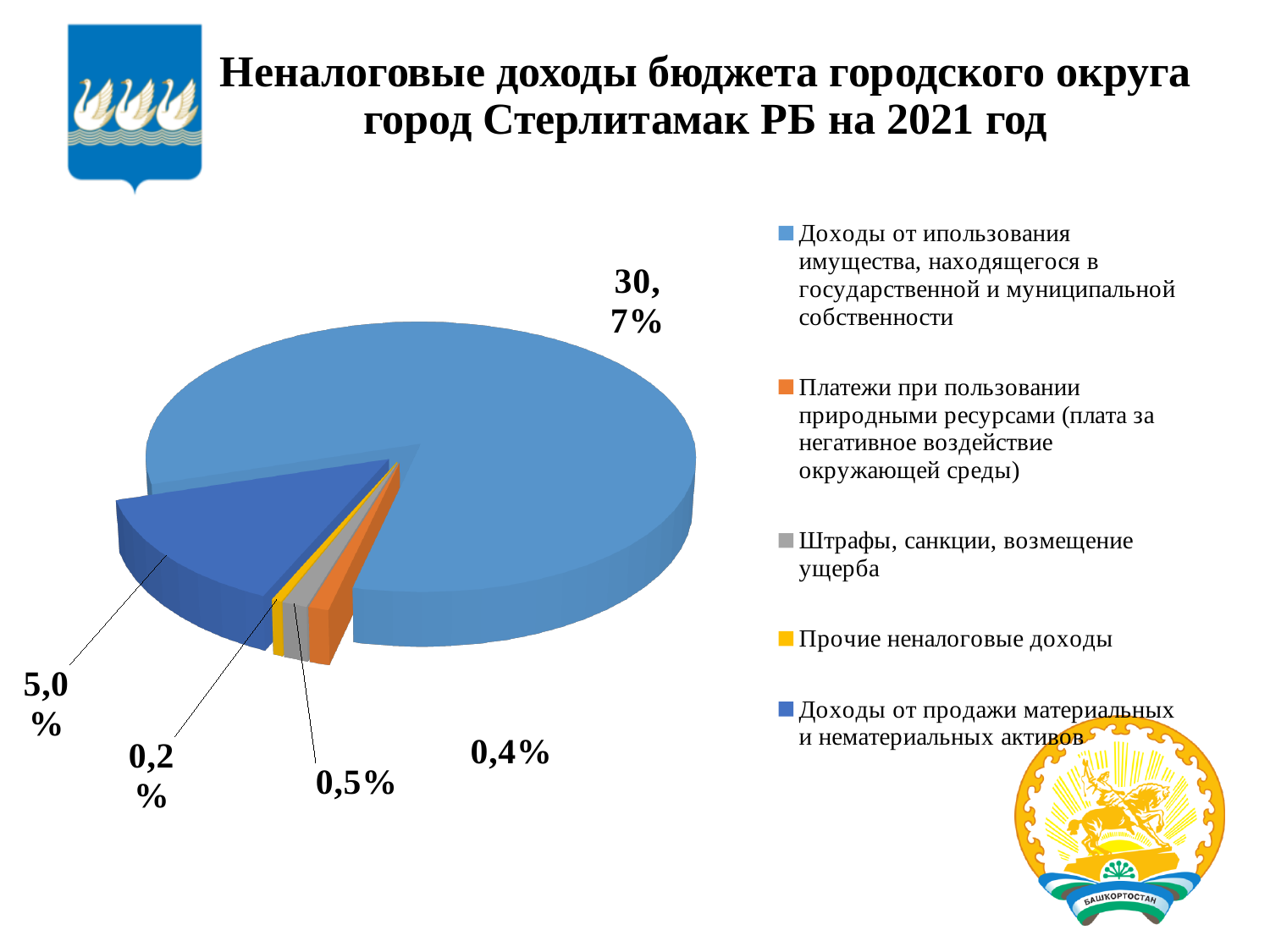
Which category has the largest slice in the pie chart? Доходы от ипользования имущества, находящегося в государственной и муниципальной собственности What is the title of the slide containing the chart? Неналоговые доходы бюджета городского округа город Стерлитамак РБ на 2021 год What is the value shown for "Прочие неналоговые доходы"? 0,2% Which category has the smallest value in the pie chart? Прочие неналоговые доходы What is the difference between the values for "Доходы от ипользования имущества" and "Доходы от продажи материальных и нематериальных активов"? 25,7% What type of chart is shown on the slide? pie chart What is the value shown for "Платежи при пользовании природными ресурсами (плата за негативное воздействие окружающей среды)"? 0,4% Which is larger: the value for "Штрафы, санкции, возмещение ущерба" or the value for "Платежи при пользовании природными ресурсами"? Штрафы, санкции, возмещение ущерба How many categories does the legend of the pie chart list? 5 What is the value shown for "Штрафы, санкции, возмещение ущерба"? 0,5% What is the value shown for "Доходы от продажи материальных и нематериальных активов"? 5,0% What is the value shown for "Доходы от ипользования имущества, находящегося в государственной и муниципальной собственности"? 30,7%